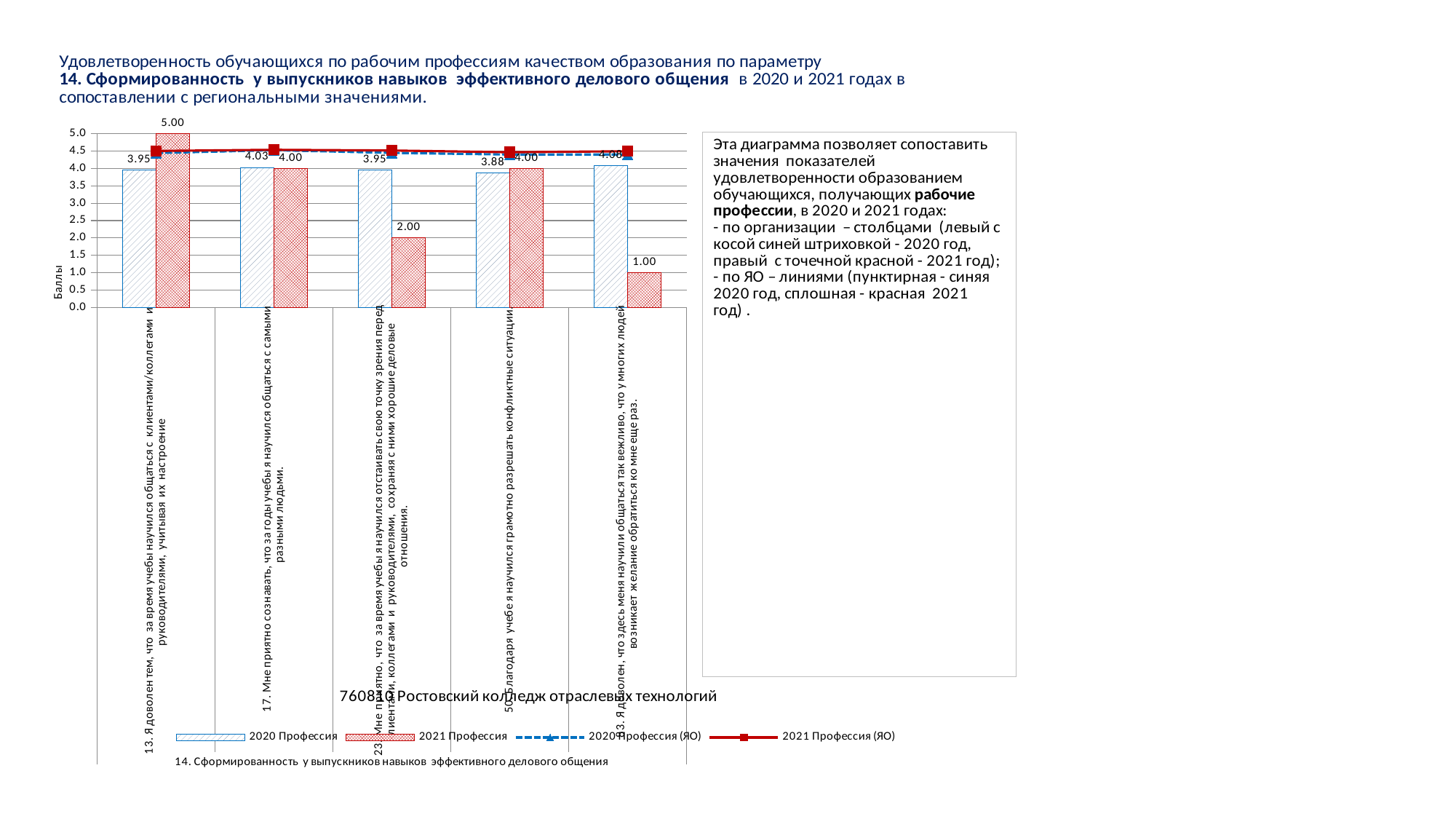
Which statement has the lowest 2020 Профессия value? 50. Благодаря учебе я научился грамотно разрешать конфликтные ситуации How many series does the chart legend list? 4 Which statement has the highest 2020 Профессия value? 83. Я доволен, что здесь меня научили общаться так вежливо, что у многих людей возникает желание обратиться ко мне еще раз. How many statements (categories) are shown on the x axis of the chart? 5 Is the 2021 Профессия (ЯО) line value for statement 13 greater or less than 4.0? greater For statement 23, how much higher is the 2020 Профессия value than the 2021 Профессия value? 1.95 For statement 17, which is larger: the 2020 Профессия value or the 2021 Профессия value? 2020 Профессия What is the value of the 2021 Профессия bar for statement 13 (Я доволен тем, что за время учебы научился общаться с клиентами/коллегами и руководителями)? 5.00 What is the value of the 2020 Профессия bar for statement 50 (Благодаря учебе я научился грамотно разрешать конфликтные ситуации)? 3.88 Which statement has the highest 2021 Профессия value? 13. Я доволен тем, что за время учебы научился общаться с клиентами/коллегами и руководителями What kind of chart is shown on the slide? Bar chart combined with line series Which statement has the lowest 2021 Профессия value? 83. Я доволен, что здесь меня научили общаться так вежливо, что у многих людей возникает желание обратиться ко мне еще раз.